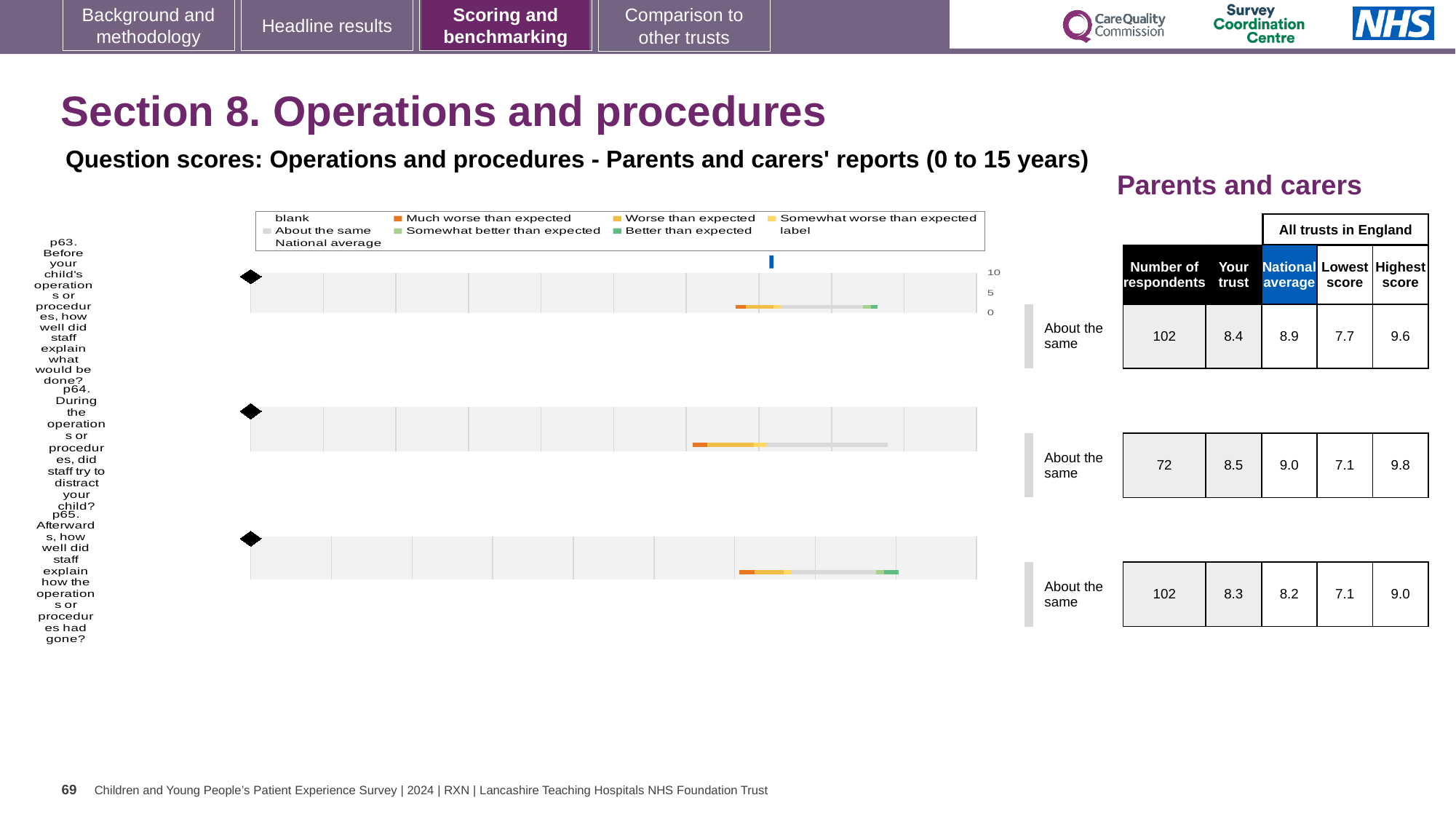
What is the highest value shown on the vertical axis of the p63 chart? 10 What colour does the legend use for 'Much worse than expected'? orange In the table beside the charts, which is larger for p63: the 'Your trust' score or the 'National average'? National average In the table beside the charts, what is the 'National average' for p64 (During the operations or procedures, did staff try to distract your child?)? 9.0 How many entries does the legend above the charts list? 9 How many question charts (p63, p64, p65) are shown on the slide? 3 In the table beside the charts, what is the 'Your trust' score for p63 (Before your child's operations or procedures, how well did staff explain what would be done?)? 8.4 What kind of chart is used for the p63, p64 and p65 question scores? bar chart In the table beside the charts, how many respondents answered p64? 72 In the table beside the charts, what is the 'Highest score' for p65 (Afterwards, how well did staff explain how the operations or procedures had gone?)? 9.0 Which benchmark category is shown next to the p65 chart? About the same In the table beside the charts, what is the difference between the 'Highest score' and 'Lowest score' for p64? 2.7